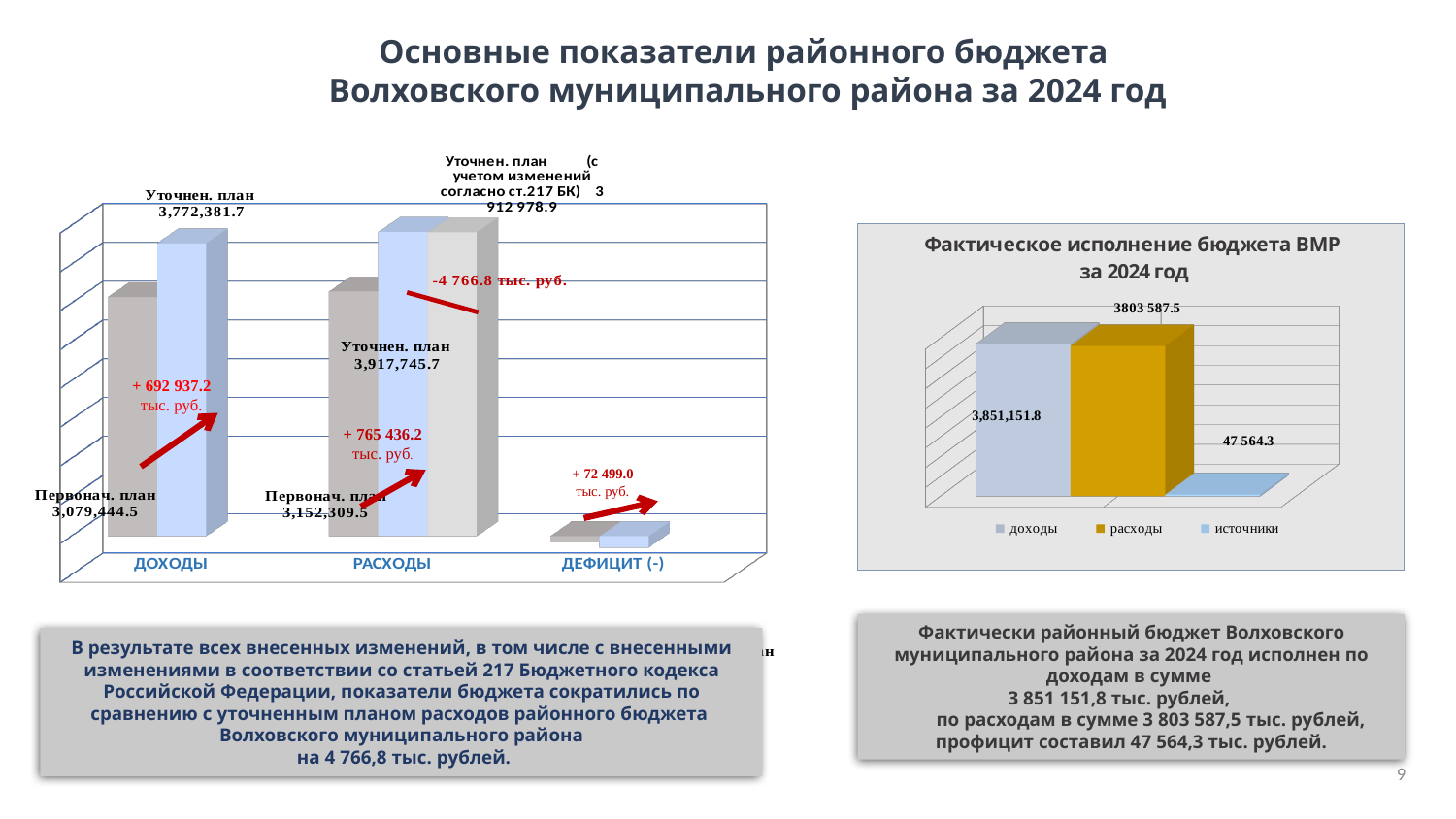
In the left chart, what is the value of Уточнен. план for ДОХОДЫ? 3,772,381.7 In the left chart, what is the value of Первонач. план for ДОХОДЫ? 3,079,444.5 In the left chart, which is larger for РАСХОДЫ: Первонач. план or Уточнен. план? Уточнен. план In the chart titled 'Фактическое исполнение бюджета ВМР за 2024 год', what is the value for доходы? 3,851,151.8 In the chart titled 'Фактическое исполнение бюджета ВМР за 2024 год', what kind of chart is shown? bar chart In the left chart, how many categories are shown on the x axis? 3 In the chart titled 'Фактическое исполнение бюджета ВМР за 2024 год', how many series does the legend list? 3 In the chart titled 'Фактическое исполнение бюджета ВМР за 2024 год', what is the value for источники? 47 564.3 In the chart titled 'Фактическое исполнение бюджета ВМР за 2024 год', what is the value for расходы? 3803 587.5 In the left chart, what is the value of Уточнен. план for РАСХОДЫ? 3,917,745.7 In the left chart, what is the value of Первонач. план for РАСХОДЫ? 3,152,309.5 In the chart titled 'Фактическое исполнение бюджета ВМР за 2024 год', which series has the lowest value? источники